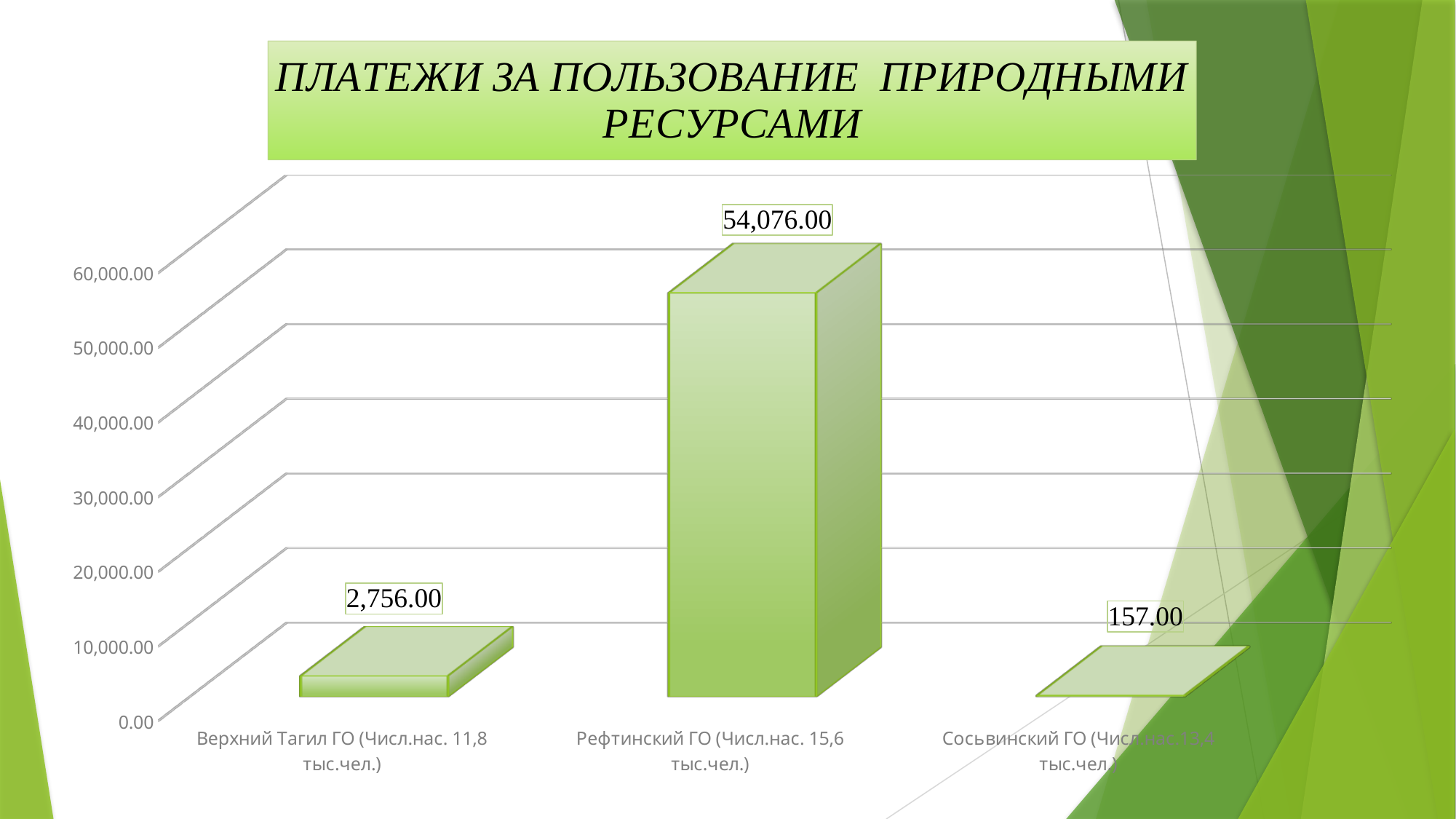
What is the title of the chart? ПЛАТЕЖИ ЗА ПОЛЬЗОВАНИЕ ПРИРОДНЫМИ РЕСУРСАМИ What kind of chart is shown on the slide? bar chart Is the value for Рефтинский ГО greater or less than 50,000.00? greater What is the value for Рефтинский ГО? 54,076.00 What is the difference between the values for Верхний Тагил ГО and Сосьвинский ГО? 2,599.00 What is the value for Верхний Тагил ГО? 2,756.00 Which is larger, the value for Верхний Тагил ГО or the value for Сосьвинский ГО? Верхний Тагил ГО Which category has the highest value? Рефтинский ГО How many categories are shown on the chart? 3 What is the difference between the values for Рефтинский ГО and Верхний Тагил ГО? 51,320.00 What is the value for Сосьвинский ГО? 157.00 Which category has the lowest value? Сосьвинский ГО